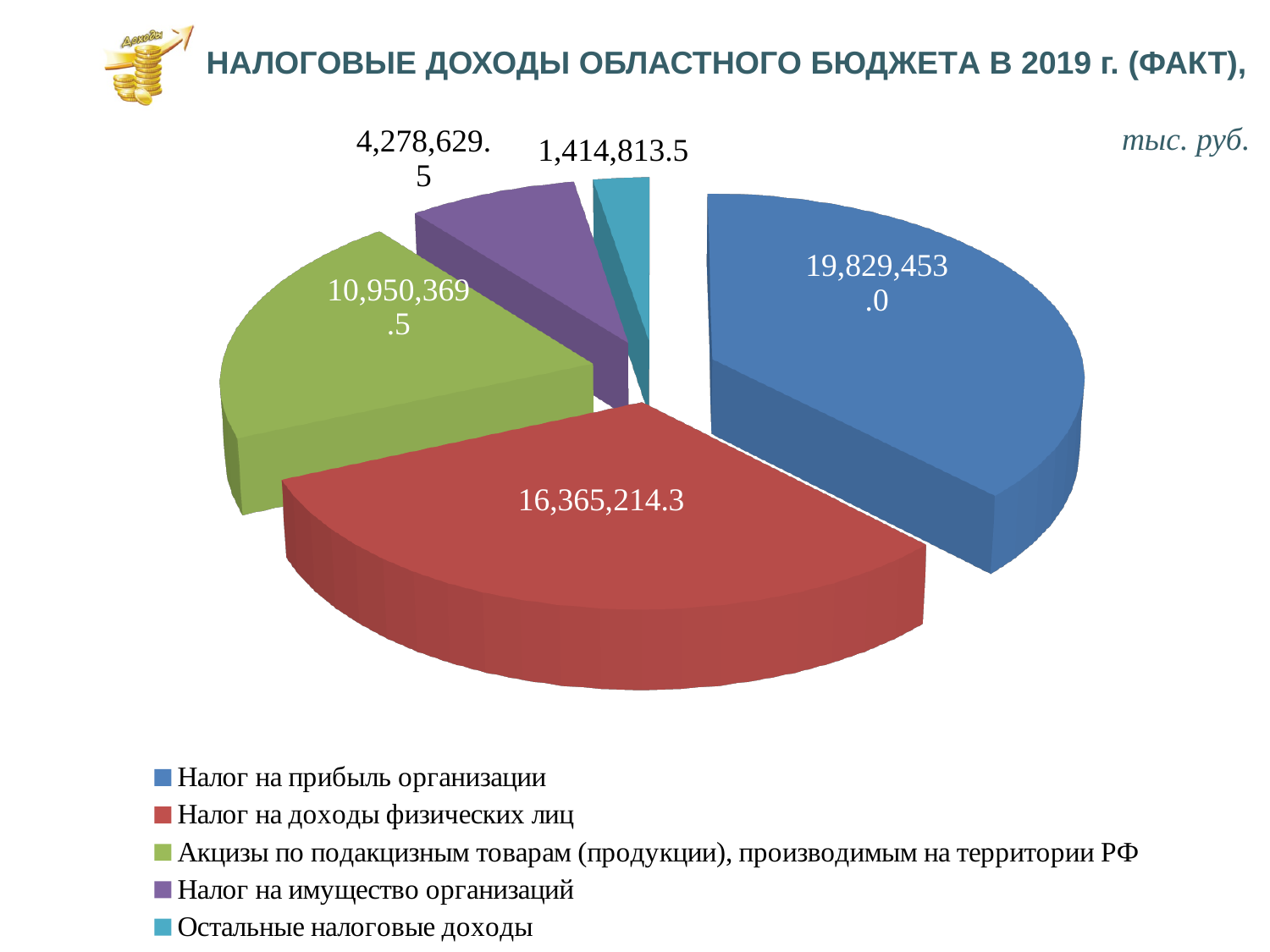
What is the difference between Налог на прибыль организации and Налог на доходы физических лиц? 3,464,238.7 What is the value for Остальные налоговые доходы? 1,414,813.5 How many entries does the legend list? 5 What unit of measurement is indicated on the slide for the chart values? тыс. руб. Which category has the smallest slice of the pie? Остальные налоговые доходы What type of chart is shown on the slide? Pie chart What is the value for Налог на прибыль организации? 19,829,453.0 Which is larger: Налог на имущество организаций or Остальные налоговые доходы? Налог на имущество организаций Which category has the largest slice of the pie? Налог на прибыль организации What is the value for Акцизы по подакцизным товарам (продукции), производимым на территории РФ? 10,950,369.5 What is the value for Налог на доходы физических лиц? 16,365,214.3 How many slices does the pie chart have? 5